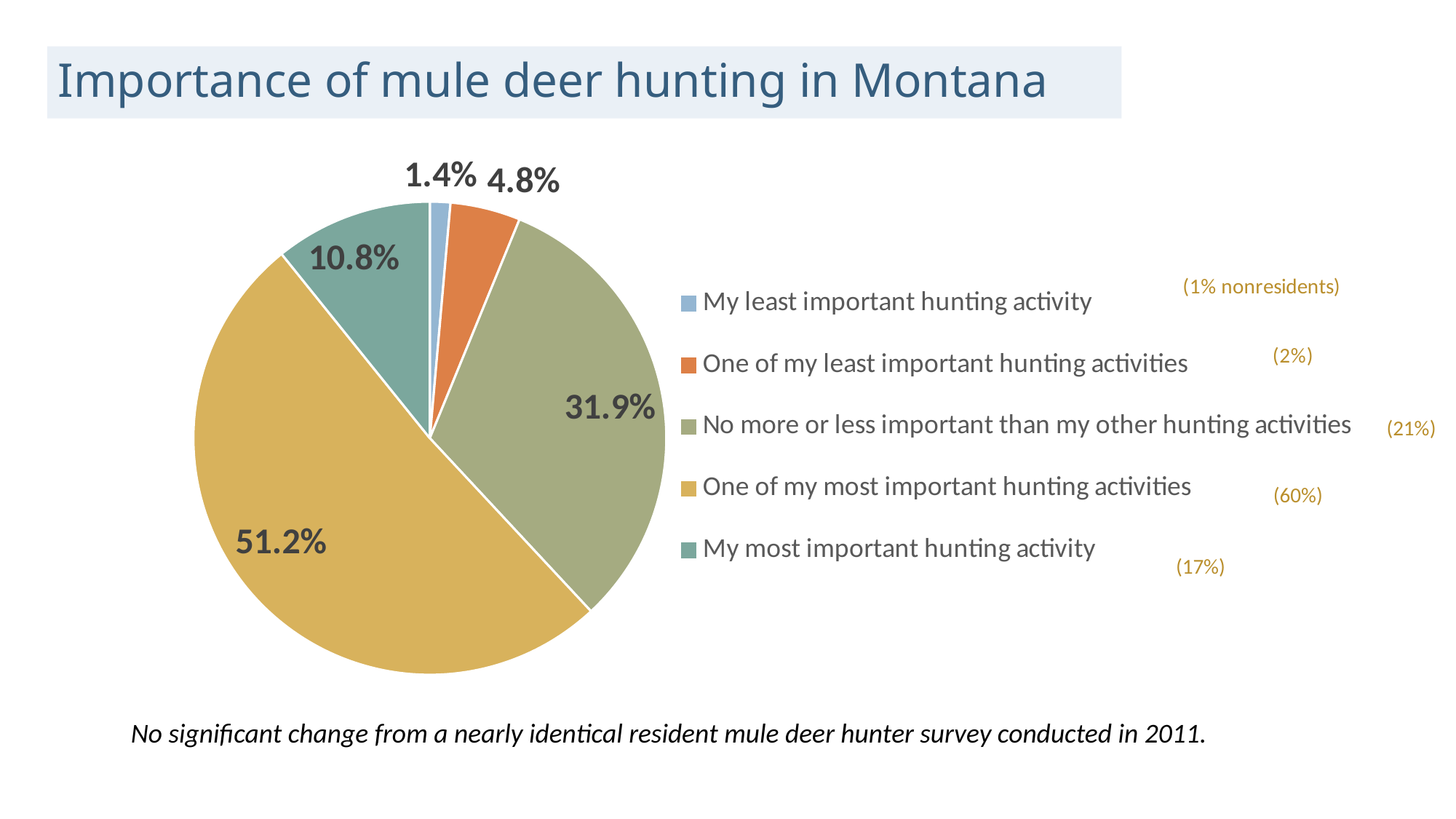
What percentage of respondents said mule deer hunting is their least important hunting activity? 1.4% What is the difference in percentage points between 'One of my most important hunting activities' and 'No more or less important than my other hunting activities'? 19.3 What percentage of respondents said mule deer hunting is their most important hunting activity? 10.8% Which category has the largest share of the pie? One of my most important hunting activities What percentage of respondents said mule deer hunting is one of their most important hunting activities? 51.2% What is the title of the slide containing the chart? Importance of mule deer hunting in Montana What percentage of respondents said mule deer hunting is one of their least important hunting activities? 4.8% What percentage of respondents said mule deer hunting is no more or less important than their other hunting activities? 31.9% How many categories are shown in the pie chart? 5 What type of chart is shown on the slide? Pie chart Which category has the smallest share of the pie? My least important hunting activity Which is larger: the share for 'My most important hunting activity' or the share for 'One of my least important hunting activities'? My most important hunting activity